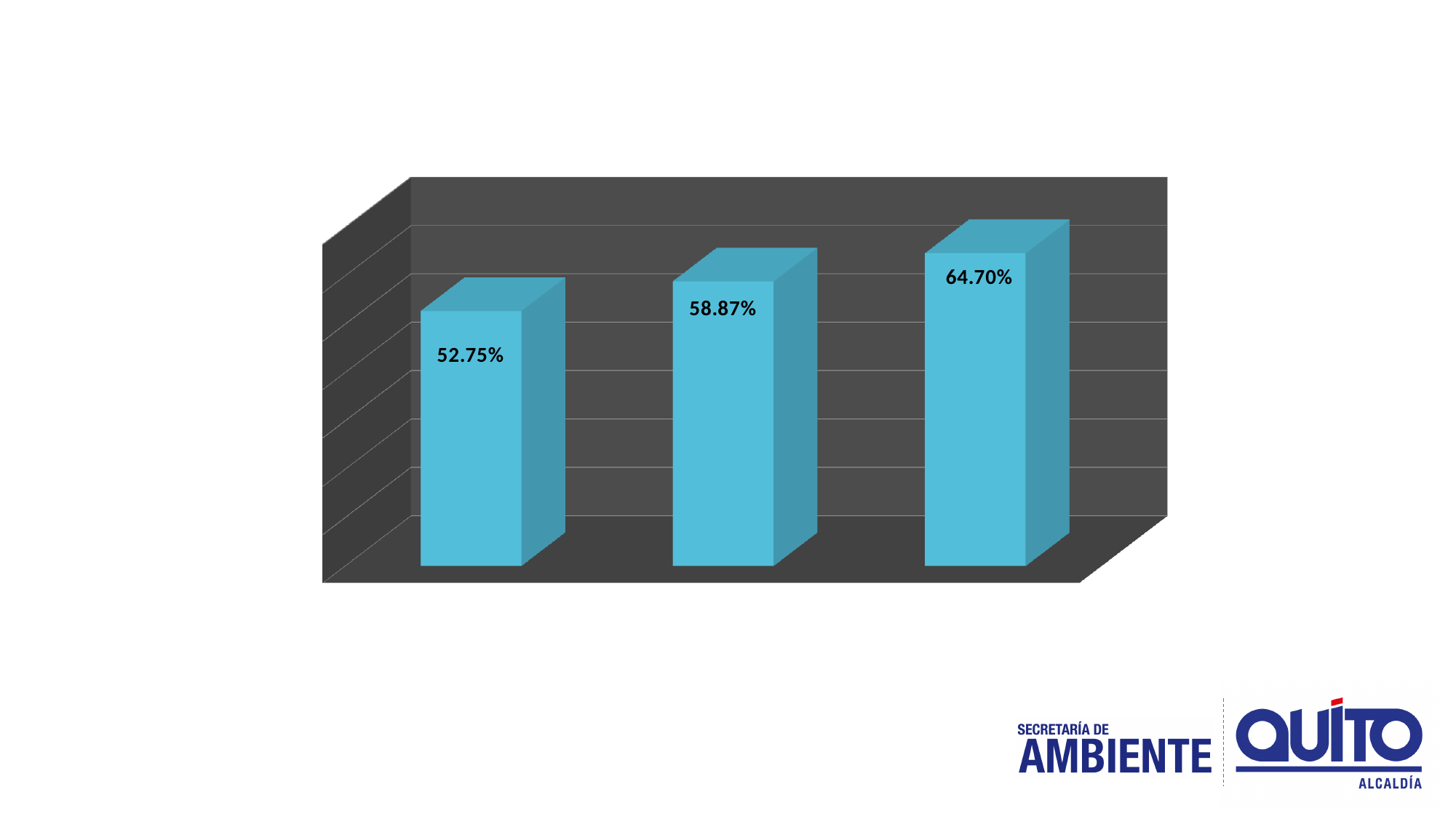
Do the bar values rise or fall from left to right? rise What value is shown on the rightmost bar? 64.70% Which bar has the highest value: the left, middle, or right one? right What value is shown on the leftmost bar? 52.75% What is the difference between the rightmost bar's value and the leftmost bar's value? 11.95% Which is larger, the value of the middle bar or the value of the rightmost bar? the rightmost bar What kind of chart is shown on the slide? bar chart What value is shown on the middle bar? 58.87% Which bar has the lowest value: the left, middle, or right one? left What is the difference between the middle bar's value and the leftmost bar's value? 6.12% What colour are the bars in the chart? blue How many bars are plotted in the chart? 3